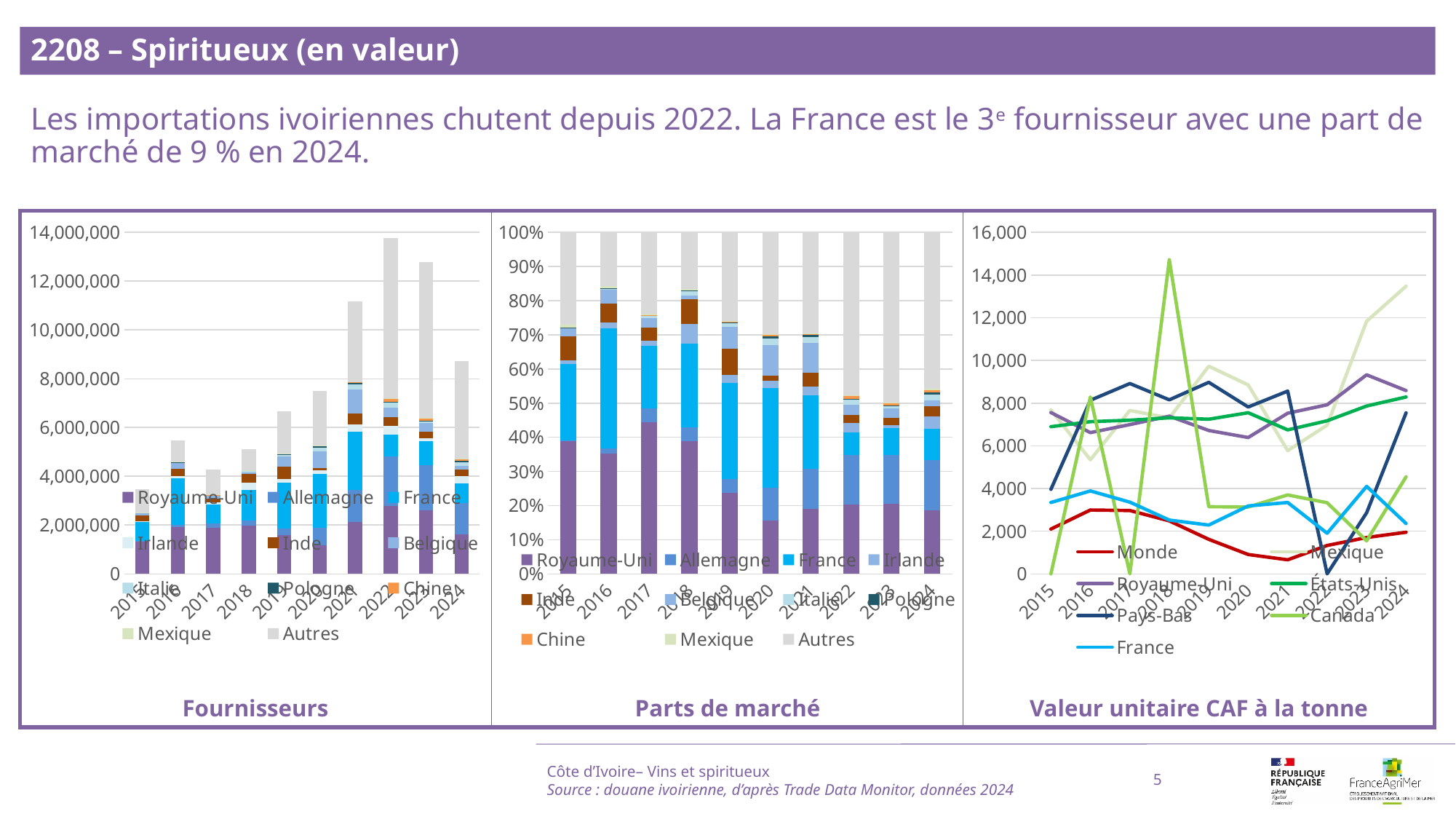
What is the title of the middle chart? Parts de marché In the "Fournisseurs" chart, how many series does the legend list? 11 In the "Fournisseurs" chart, which year has the shortest total bar? 2015 In the "Fournisseurs" chart, which year has the tallest total bar? 2022 What kind of chart is the "Valeur unitaire CAF à la tonne" chart on the right? line chart In the "Fournisseurs" chart, do the total bars rise or fall from 2022 to 2024? fall In the "Fournisseurs" chart, is the total bar for 2024 greater or less than 10,000,000? less What kind of chart is the "Fournisseurs" chart on the left? bar chart In the "Fournisseurs" chart, is the total bar for 2022 greater or less than 12,000,000? greater In the "Fournisseurs" chart, how many years are shown on the x axis? 10 In the "Valeur unitaire CAF à la tonne" chart, how many series does the legend list? 7 In the "Valeur unitaire CAF à la tonne" chart, is the value for Canada in 2018 greater or less than 14,000? greater